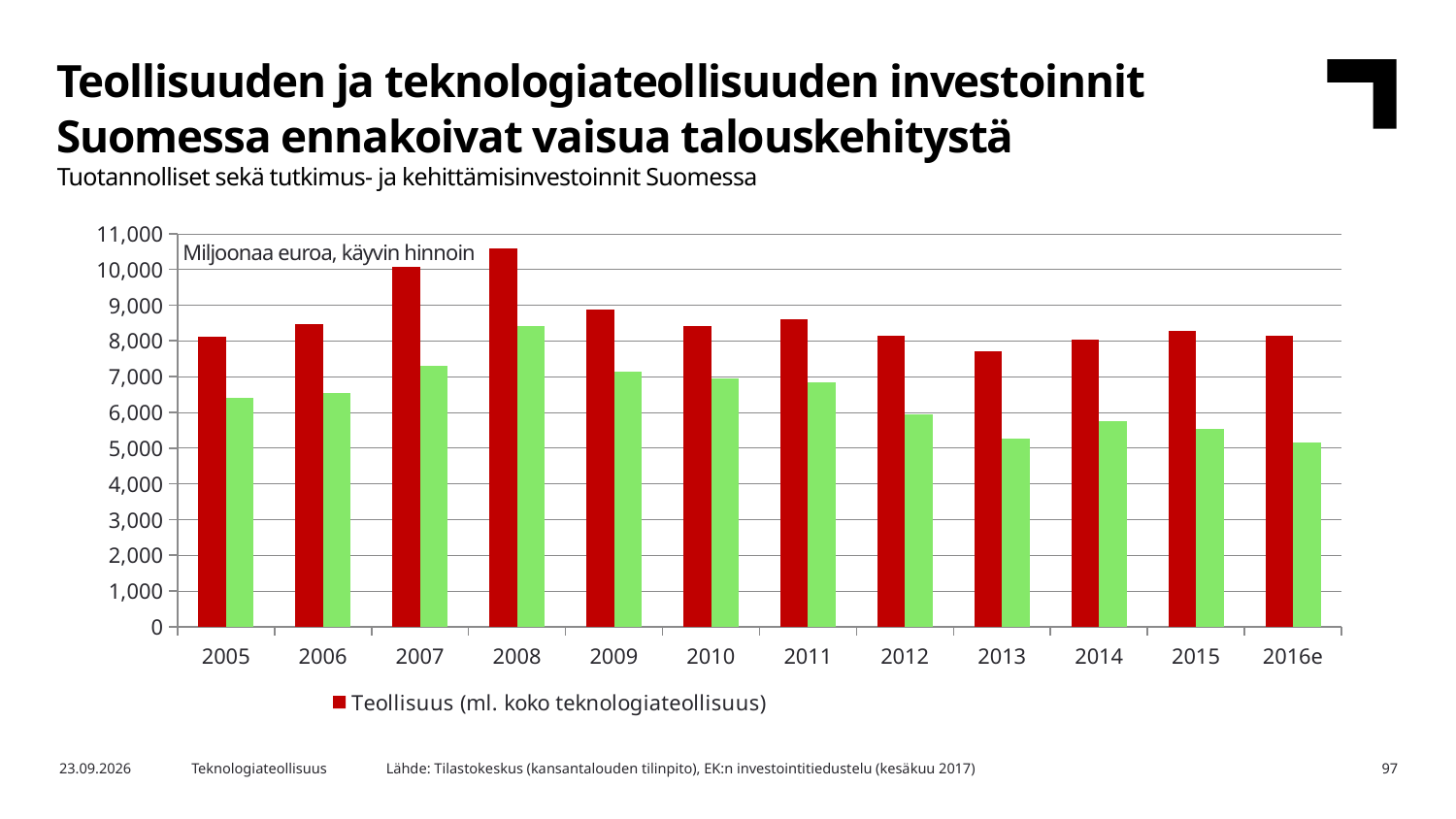
Is the value for Teollisuus (ml. koko teknologiateollisuus) in 2008 greater or less than 10,000? greater How many series does the legend list? 1 What unit is stated in the label inside the plot area? Miljoonaa euroa, käyvin hinnoin Do the green bars rise or fall from 2008 to 2013? fall Which is larger, the Teollisuus (ml. koko teknologiateollisuus) value in 2007 or in 2008? 2008 In which year is the value for Teollisuus (ml. koko teknologiateollisuus) highest? 2008 In which year is the value for Teollisuus (ml. koko teknologiateollisuus) lowest? 2013 What kind of chart is shown on the slide? bar chart In which year are the green bars highest? 2008 Is the value for Teollisuus (ml. koko teknologiateollisuus) in 2013 greater or less than 8,000? less How many years (categories) are shown on the x axis? 12 Is the green bar for 2008 greater or less than 8,000? greater